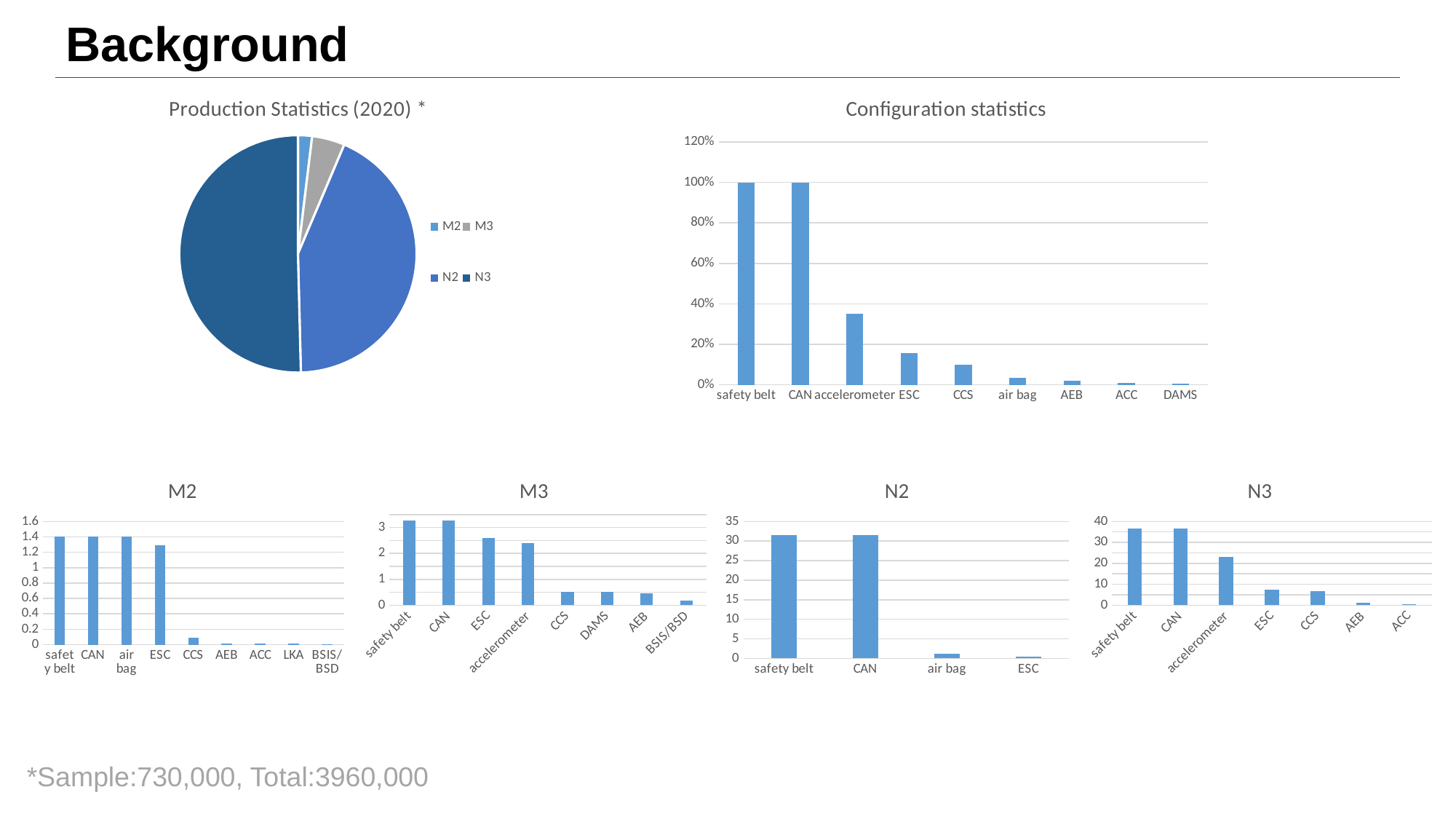
What kind of chart is the 'Production Statistics (2020)' chart? pie chart In the 'N3' chart, is the value for accelerometer greater or less than 20? greater In the 'Configuration statistics' chart, which is larger, ESC or CCS? ESC How many entries does the legend of the 'Production Statistics (2020)' pie chart list? 4 How many categories are shown on the x axis of the 'N2' chart? 4 What kind of chart is the 'Configuration statistics' chart? bar chart In the 'Configuration statistics' chart, what is the value for safety belt? 100% How many categories are shown on the x axis of the 'Configuration statistics' chart? 9 In the 'Configuration statistics' chart, is the value for accelerometer greater or less than 40%? less In the 'M3' chart, which category has the lowest value? BSIS/BSD In the 'Production Statistics (2020)' pie chart, which category has the smallest slice? M2 In the 'Configuration statistics' chart, do the values rise or fall from left to right along the x axis? fall